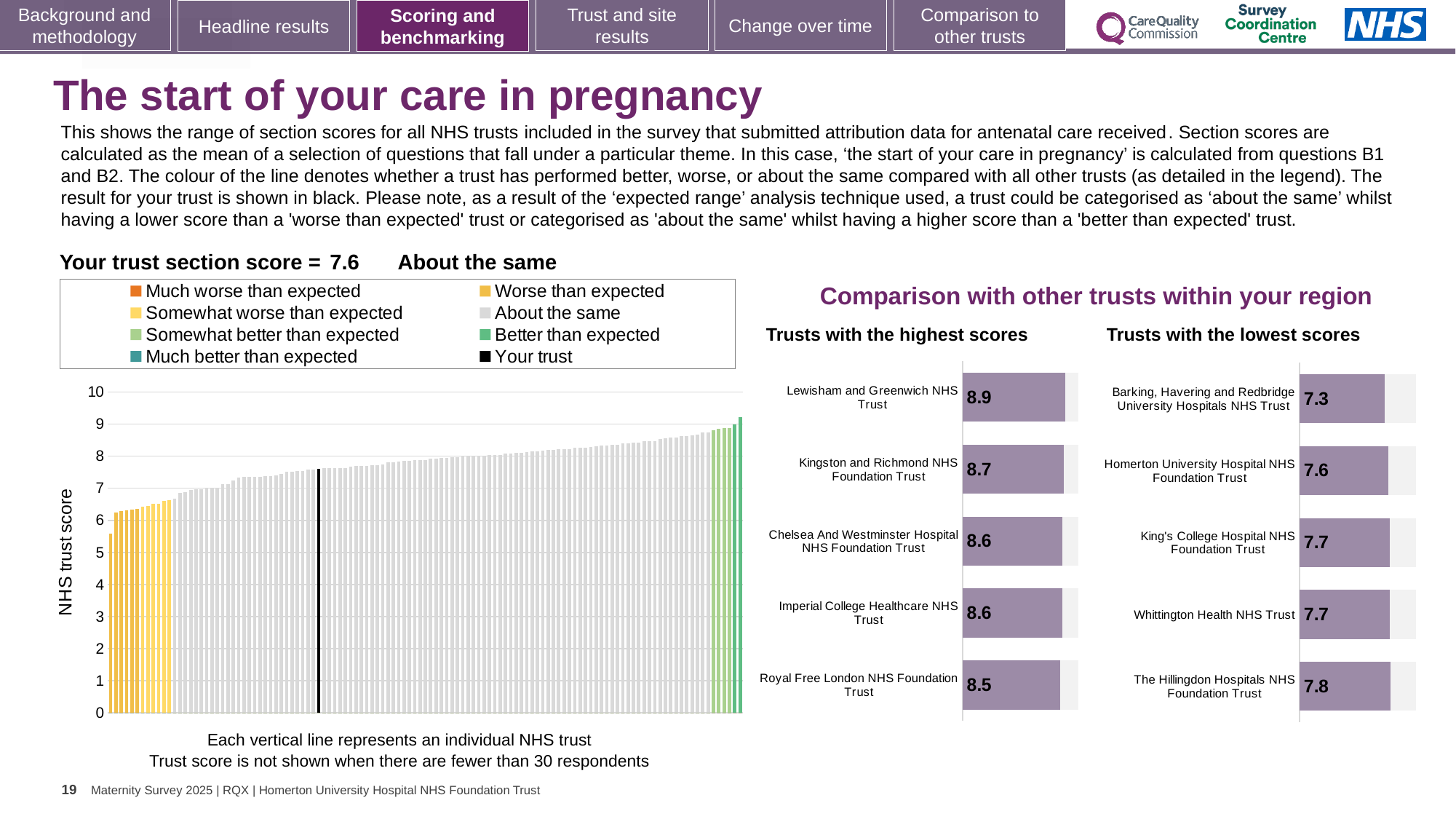
How many entries does the legend above the 'NHS trust score' chart list? 8 What type of chart is the 'NHS trust score' chart on the left of the slide? Bar chart What is the section score for your trust shown above the 'NHS trust score' chart? 7.6 How many trusts are shown in the 'Trusts with the highest scores' chart? 5 In the 'Trusts with the lowest scores' chart, what is the score for Barking, Havering and Redbridge University Hospitals NHS Trust? 7.3 In the 'Trusts with the highest scores' chart, what is the score for Lewisham and Greenwich NHS Trust? 8.9 In the 'Trusts with the highest scores' chart, what is the difference between the scores of Lewisham and Greenwich NHS Trust and Royal Free London NHS Foundation Trust? 0.4 In the 'NHS trust score' chart on the left, is the value for the leftmost bar greater or less than 7? less In the 'Trusts with the highest scores' chart, which trust has the highest score? Lewisham and Greenwich NHS Trust In the 'NHS trust score' chart on the left, do the bar values rise or fall from left to right? Rise In the 'Trusts with the lowest scores' chart, which has the larger score: Barking, Havering and Redbridge University Hospitals NHS Trust or The Hillingdon Hospitals NHS Foundation Trust? The Hillingdon Hospitals NHS Foundation Trust In the 'Trusts with the lowest scores' chart, which trust has the lowest score? Barking, Havering and Redbridge University Hospitals NHS Trust